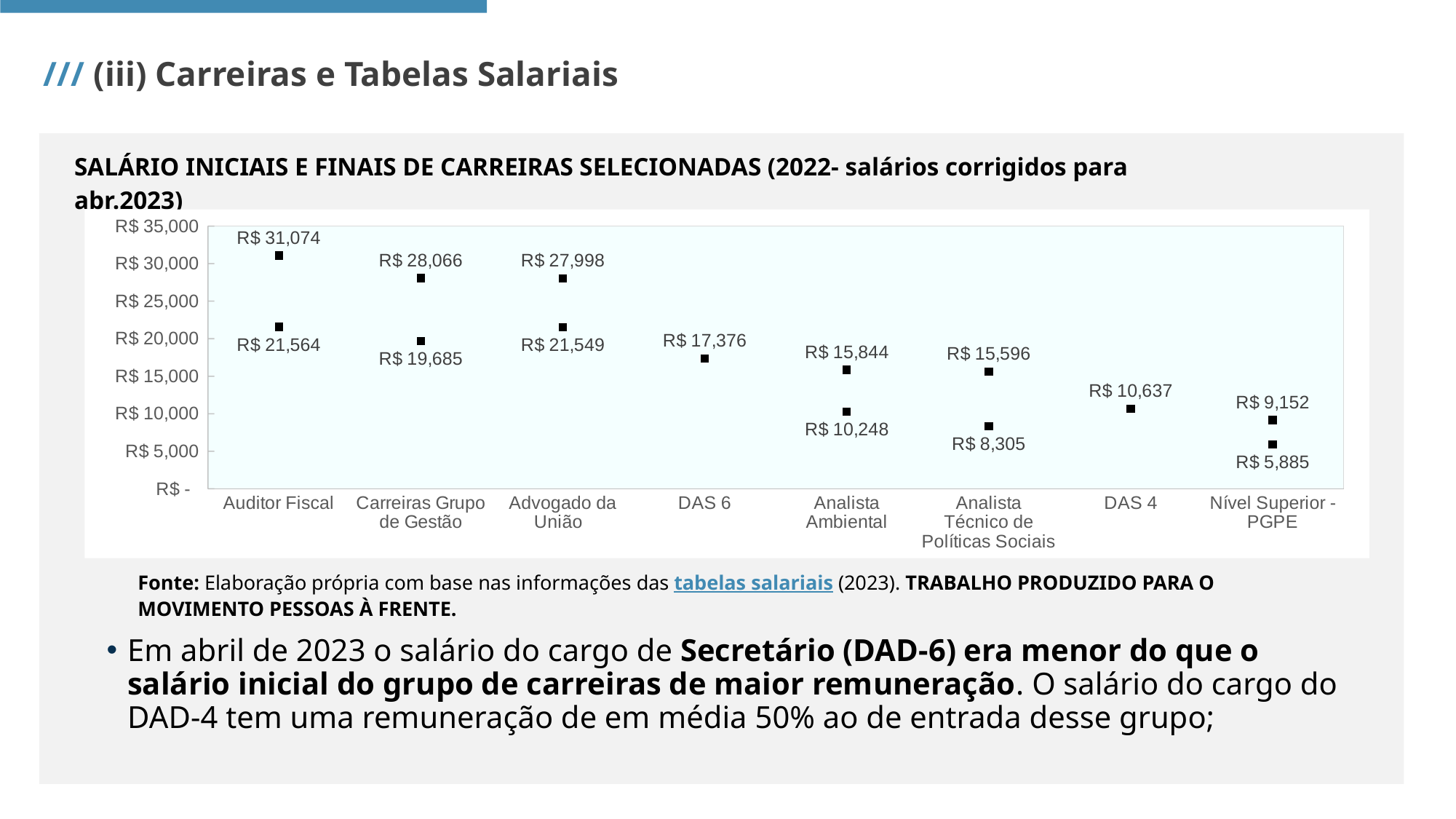
What is the difference between the two salary values shown for Analista Ambiental? R$ 5,596 What is the title of the chart? SALÁRIO INICIAIS E FINAIS DE CARREIRAS SELECIONADAS (2022- salários corrigidos para abr.2023) What is the difference between the two salary values shown for Auditor Fiscal? R$ 9,510 Which career has the highest salary value on the chart? Auditor Fiscal Which career has the lowest salary value on the chart? Nível Superior - PGPE Which is larger: the salary for DAS 6 or the higher salary for Analista Ambiental? DAS 6 What salary value is shown for DAS 4? R$ 10,637 How many careers are shown on the x axis of the chart? 8 What is the lower salary value shown for Nível Superior - PGPE? R$ 5,885 What is the highest salary value shown for Auditor Fiscal? R$ 31,074 What salary value is shown for DAS 6? R$ 17,376 What is the lower salary value shown for Carreiras Grupo de Gestão? R$ 19,685